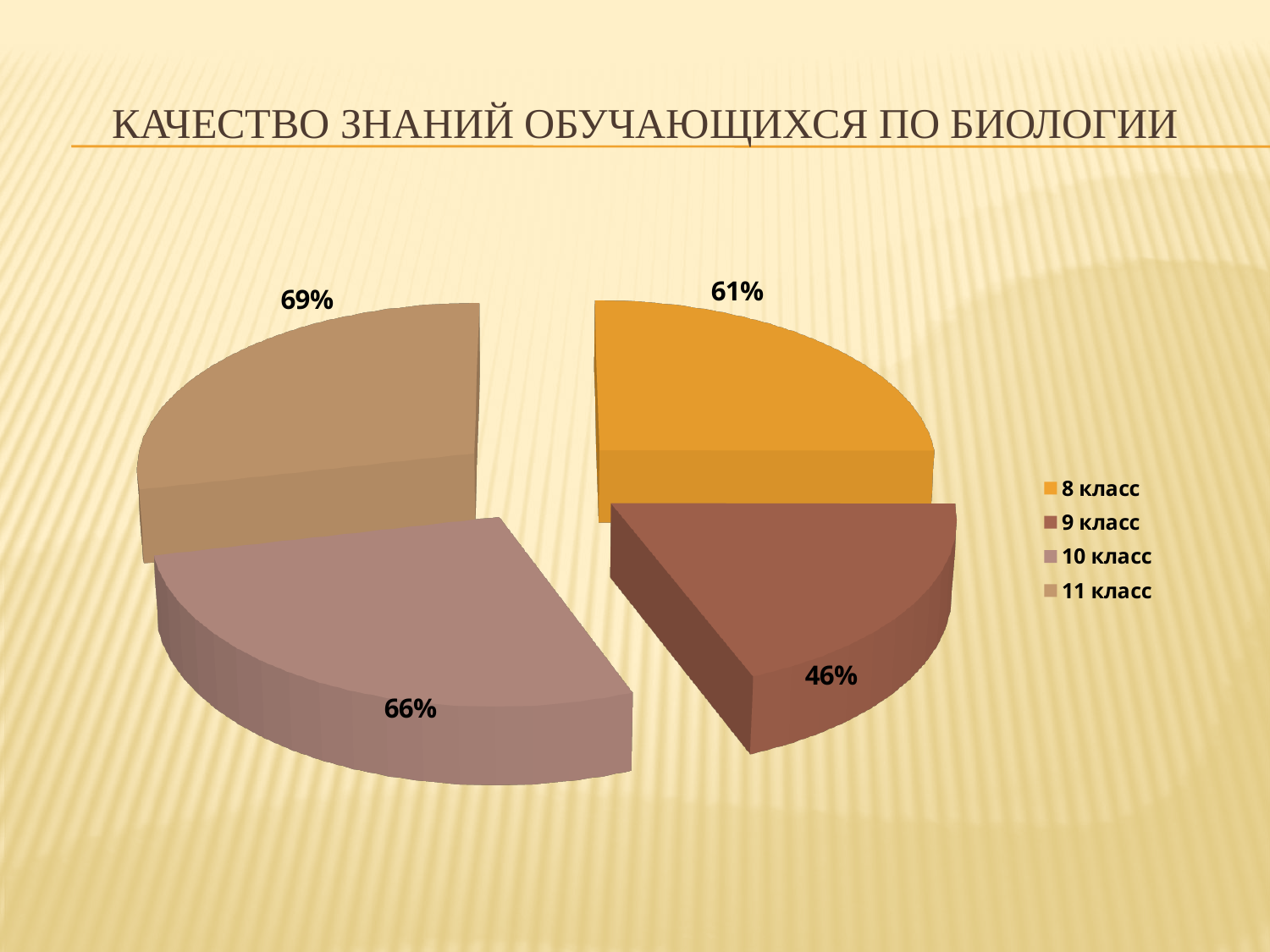
Which has a larger value, 8 класс or 9 класс? 8 класс What value is shown for 11 класс? 69% What value is shown for 10 класс? 66% What kind of chart is shown on the slide? Pie chart What value is shown for 8 класс? 61% What is the difference between the values for 11 класс and 9 класс? 23% How many slices does the pie chart have? 4 Which class has the highest value on the chart? 11 класс What is the difference between the values for 10 класс and 8 класс? 5% What value is shown for 9 класс? 46% Which class has the lowest value on the chart? 9 класс What is the title of the chart on the slide? Качество знаний обучающихся по биологии